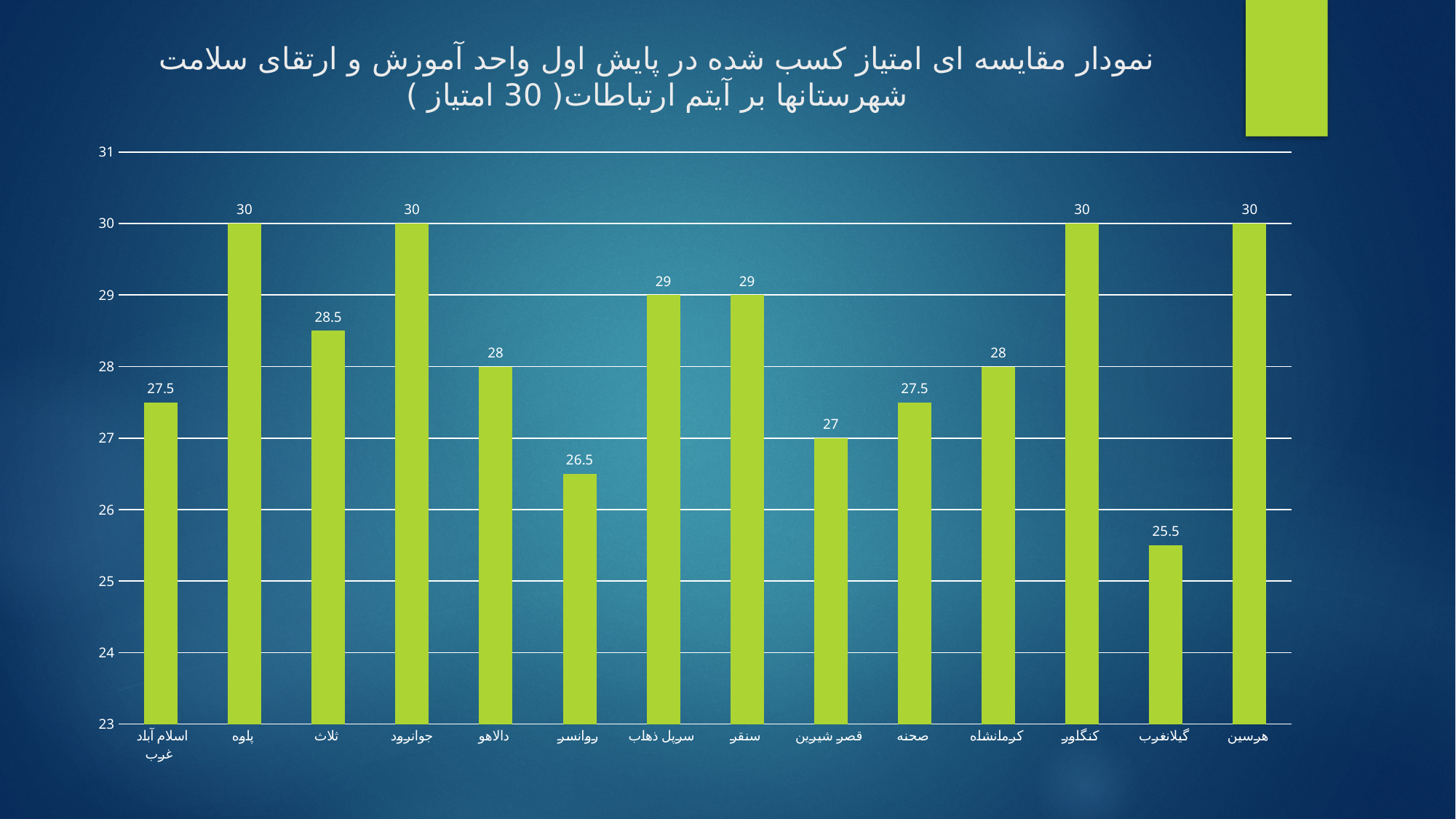
What is the value for روانسر? 26.5 Which category has the lowest value? گیلانغرب What is the difference between the values for پاوه and گیلانغرب? 4.5 What is the difference between the values for سنقر and دالاهو? 1 Which is larger, the value for صحنه or the value for روانسر? صحنه What kind of chart is shown on the slide? bar chart What is the value for گیلانغرب? 25.5 How many categories have a value of 30? 4 How many categories are shown on the x axis? 14 What is the value for ثلاث? 28.5 What is the value for قصر شیرین? 27 Which is larger, the value for کرمانشاه or the value for ثلاث? ثلاث